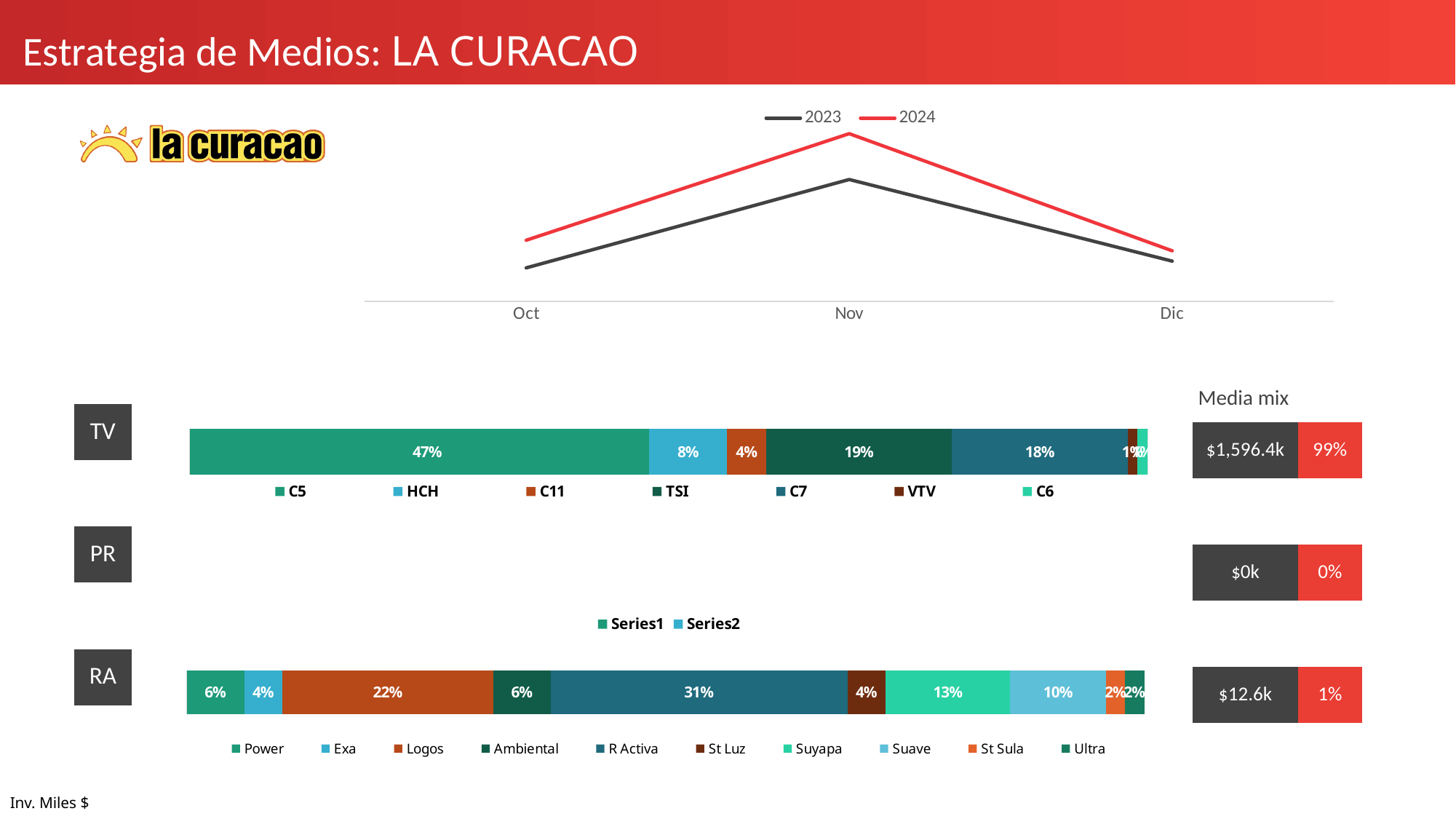
In the TV stacked bar chart, what share does TSI have? 19% In the RA stacked bar chart, which is larger, the share of Suave or the share of Exa? Suave In the TV stacked bar chart, what share does C5 have? 47% In the line chart at the top, how many series does the legend list? 2 In the TV stacked bar chart, which channel has the largest share? C5 In the line chart at the top, how many months are shown on the x axis? 3 In the line chart at the top, in which month do both lines reach their highest point? Nov In the RA stacked bar chart, what share does R Activa have? 31% In the line chart at the top, do the values rise or fall from Nov to Dic? fall In the RA stacked bar chart, what is the difference between the shares of Logos and Suyapa? 9% In the TV stacked bar chart, how many channels does the legend list? 7 In the line chart at the top, which series is higher in Nov, 2023 or 2024? 2024